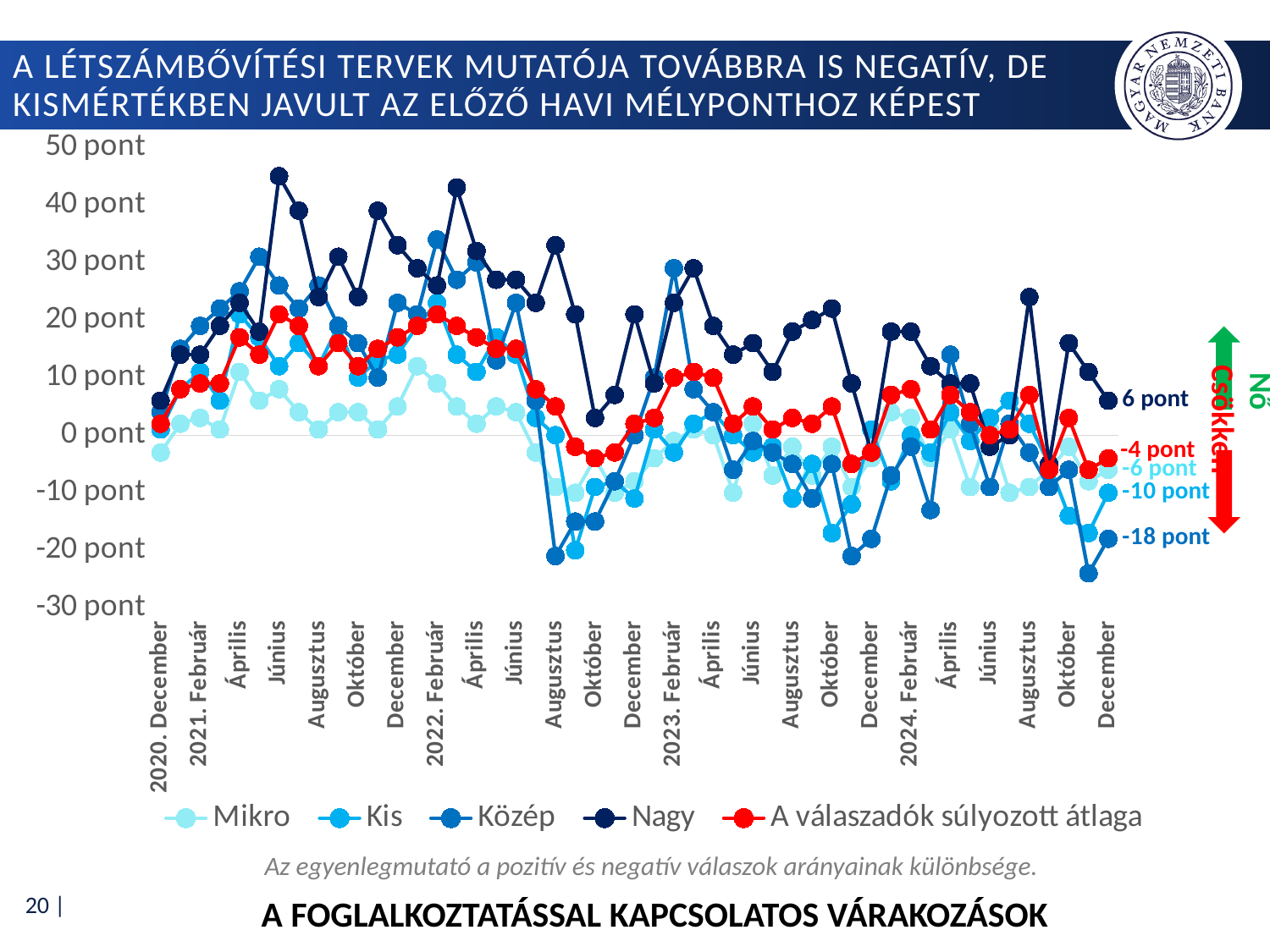
What is the latest value shown for the Kis series? -10 pont How many series does the legend list? 5 At the end of the chart, which is larger: the Kis value or the Közép value? Kis What is the latest (December 2024) value shown for the Nagy series? 6 pont What is the latest value shown for 'A válaszadók súlyozott átlaga'? -4 pont What is the latest value shown for the Mikro series? -6 pont What is the latest value shown for the Közép series? -18 pont What kind of chart is shown on the slide? Line chart Which series has the lowest value at the end of the chart (December 2024)? Közép Which series has the highest value at the end of the chart (December 2024)? Nagy Is the value for the Nagy series in June 2021 greater or less than 40 pont? greater What is the difference between the final values of the Nagy and Közép series? 24 pont